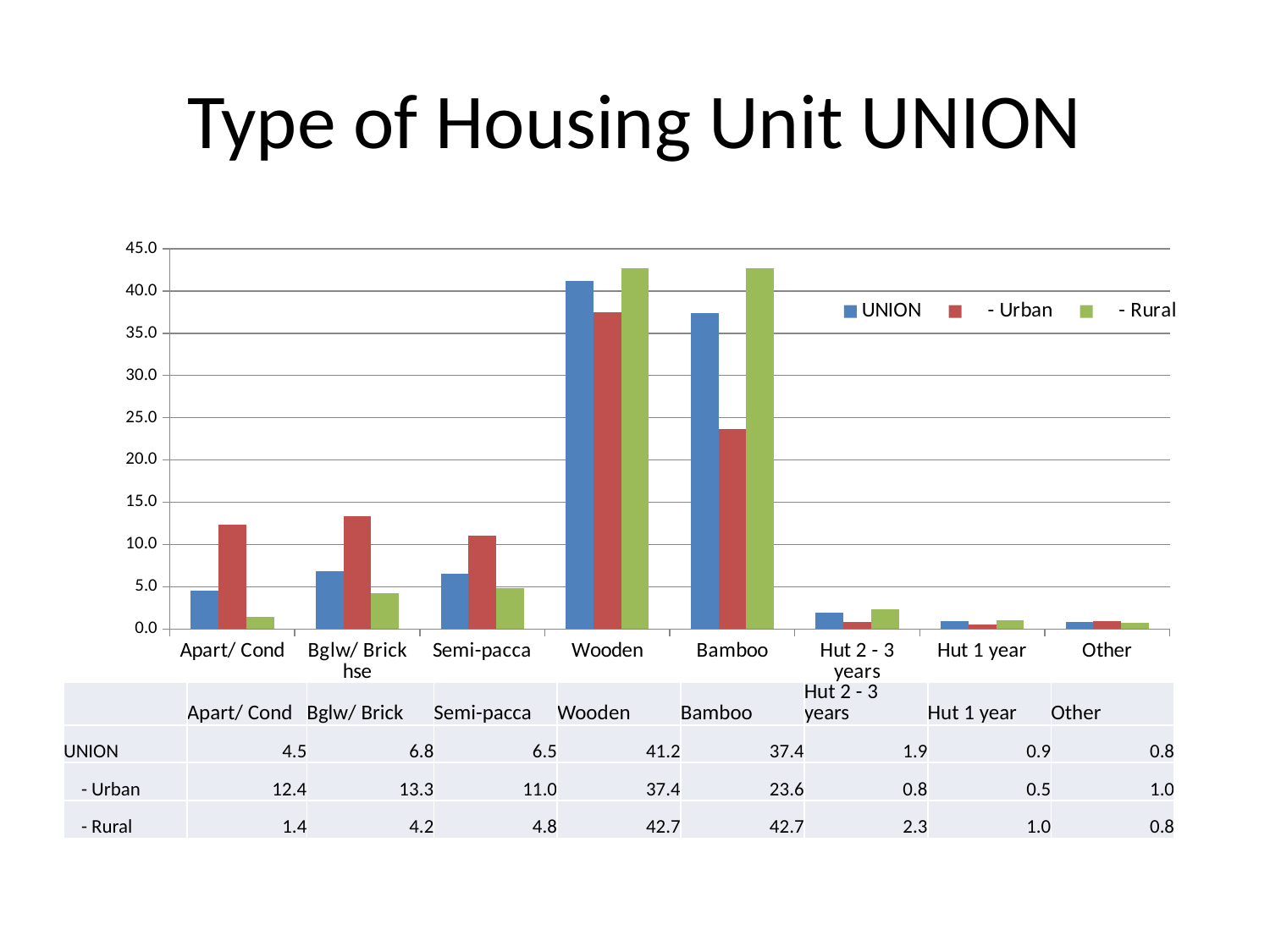
How many housing type categories are shown on the x axis? 8 What is the Rural value for Apart/ Cond? 1.4 Is the Rural value for Wooden greater or less than 40.0? greater What kind of chart is shown on the slide? Bar chart Which housing type has the highest UNION value? Wooden How many series does the legend list? 3 Which is larger for Bglw/ Brick hse: the Urban value or the Rural value? Urban Which housing type has the lowest Urban value? Hut 1 year What is the Urban value for Bamboo housing units? 23.6 What is the UNION value for Wooden housing units? 41.2 What is the title of the chart? Type of Housing Unit UNION What is the difference between the Rural and Urban values for Bamboo? 19.1